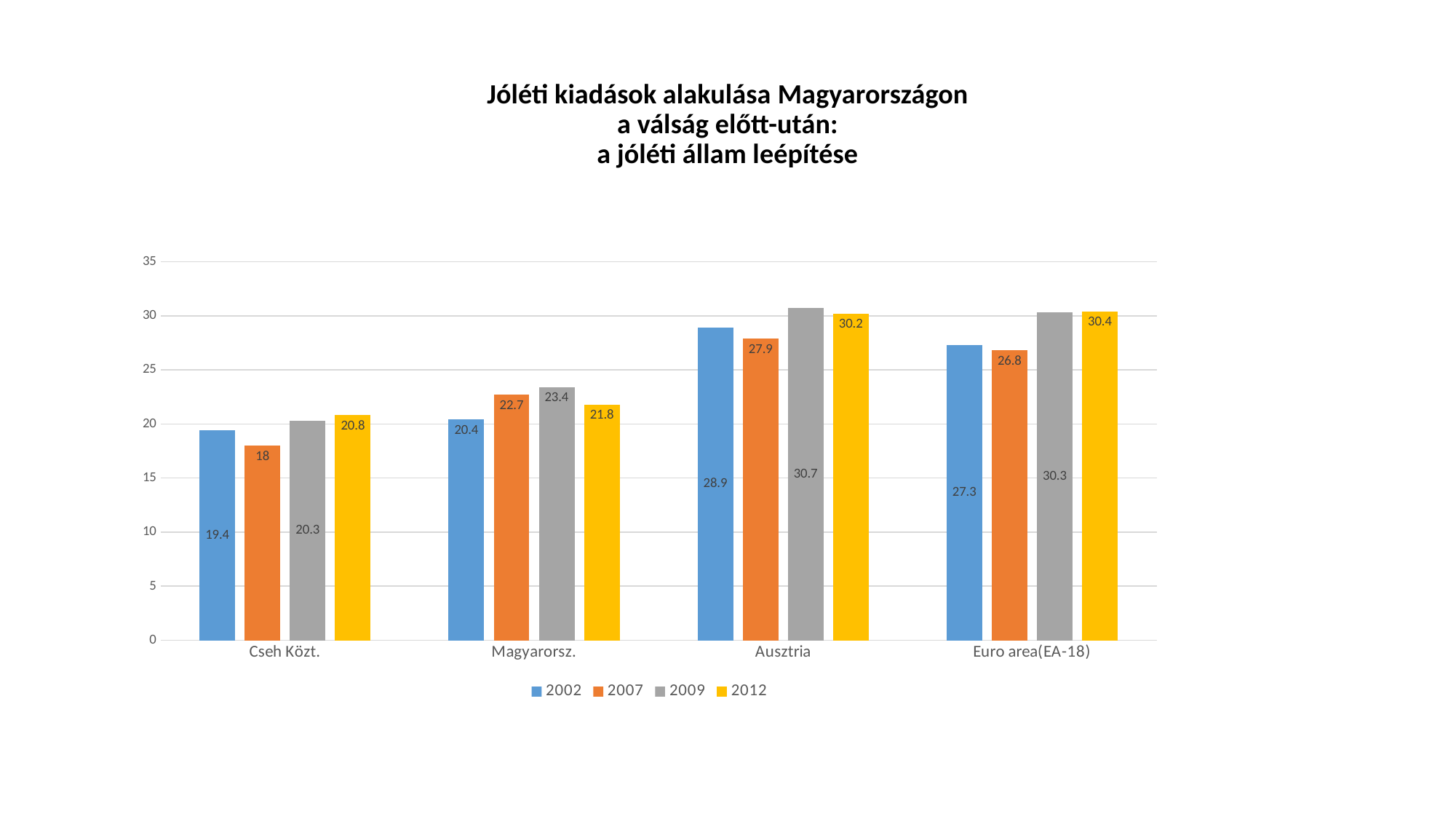
What is the value for Euro area(EA-18) in the 2012 series? 30.4 How many categories are shown on the x axis? 4 How many series does the legend list? 4 What is the value for Magyarorsz. in the 2009 series? 23.4 What is the value for Ausztria in the 2002 series? 28.9 Which category has the highest value in the 2009 series? Ausztria What is the difference between the 2009 and 2002 values for Magyarorsz.? 3 What kind of chart is shown on the slide? Bar chart Which category has the lowest value in the 2012 series? Cseh Közt. Which colour represents the 2012 series in the legend? Yellow What is the value for Cseh Közt. in the 2007 series? 18 Which is larger for Ausztria: the 2002 value or the 2007 value? 2002